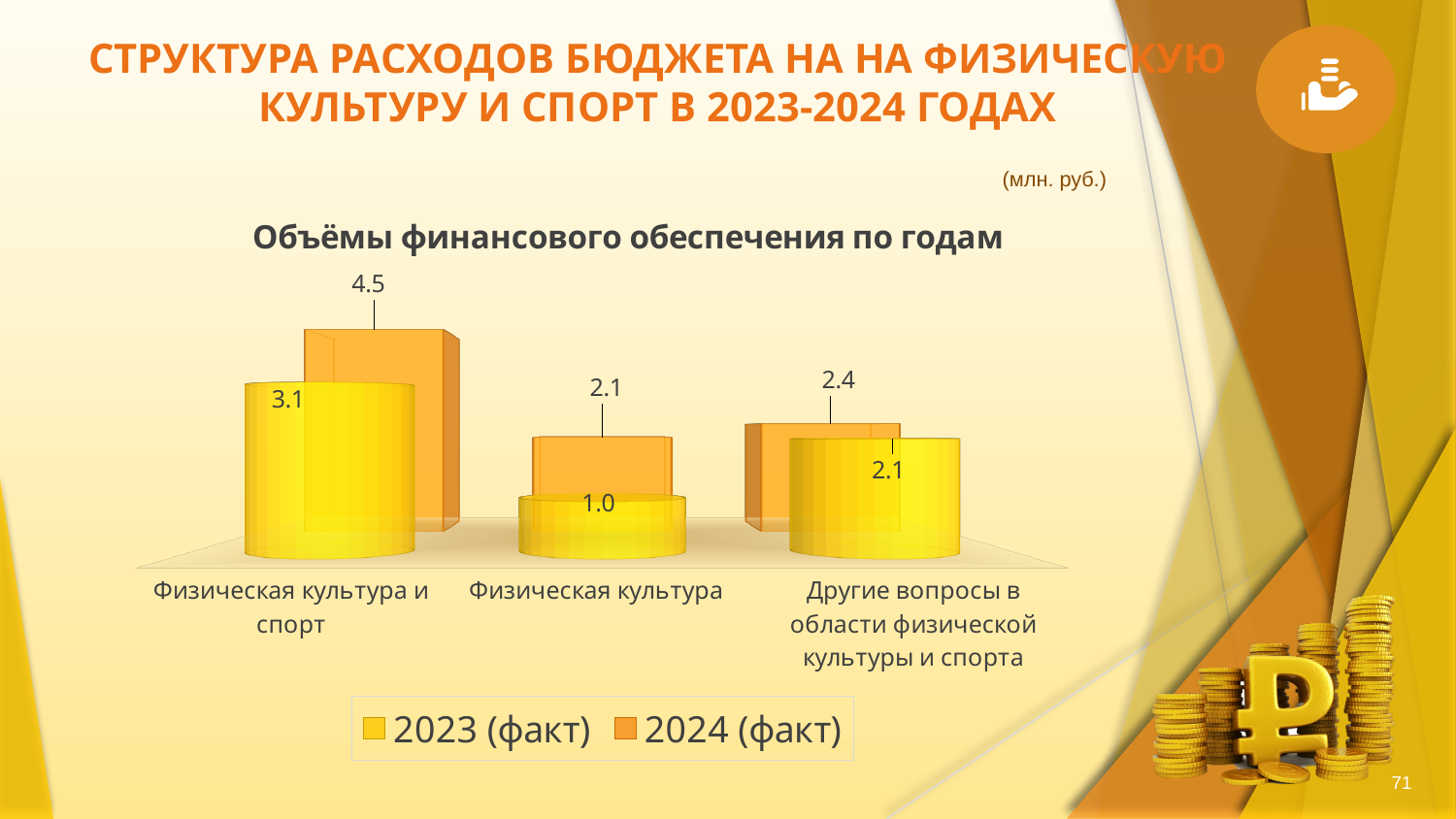
How many categories are shown on the x axis? 3 Which category has the highest 2024 (факт) value? Физическая культура и спорт What is the difference between the 2024 (факт) and 2023 (факт) values for Физическая культура? 1.1 What is the difference between the 2024 (факт) and 2023 (факт) values for Физическая культура и спорт? 1.4 What is the title of the chart? Объёмы финансового обеспечения по годам Which category has the lowest 2023 (факт) value? Физическая культура How many series does the legend list? 2 What is the 2024 (факт) value for Другие вопросы в области физической культуры и спорта? 2.4 Which is larger for Другие вопросы в области физической культуры и спорта: the 2023 (факт) value or the 2024 (факт) value? 2024 (факт) What is the 2023 (факт) value for Физическая культура? 1.0 What is the 2023 (факт) value for Физическая культура и спорт? 3.1 What is the 2024 (факт) value for Физическая культура и спорт? 4.5